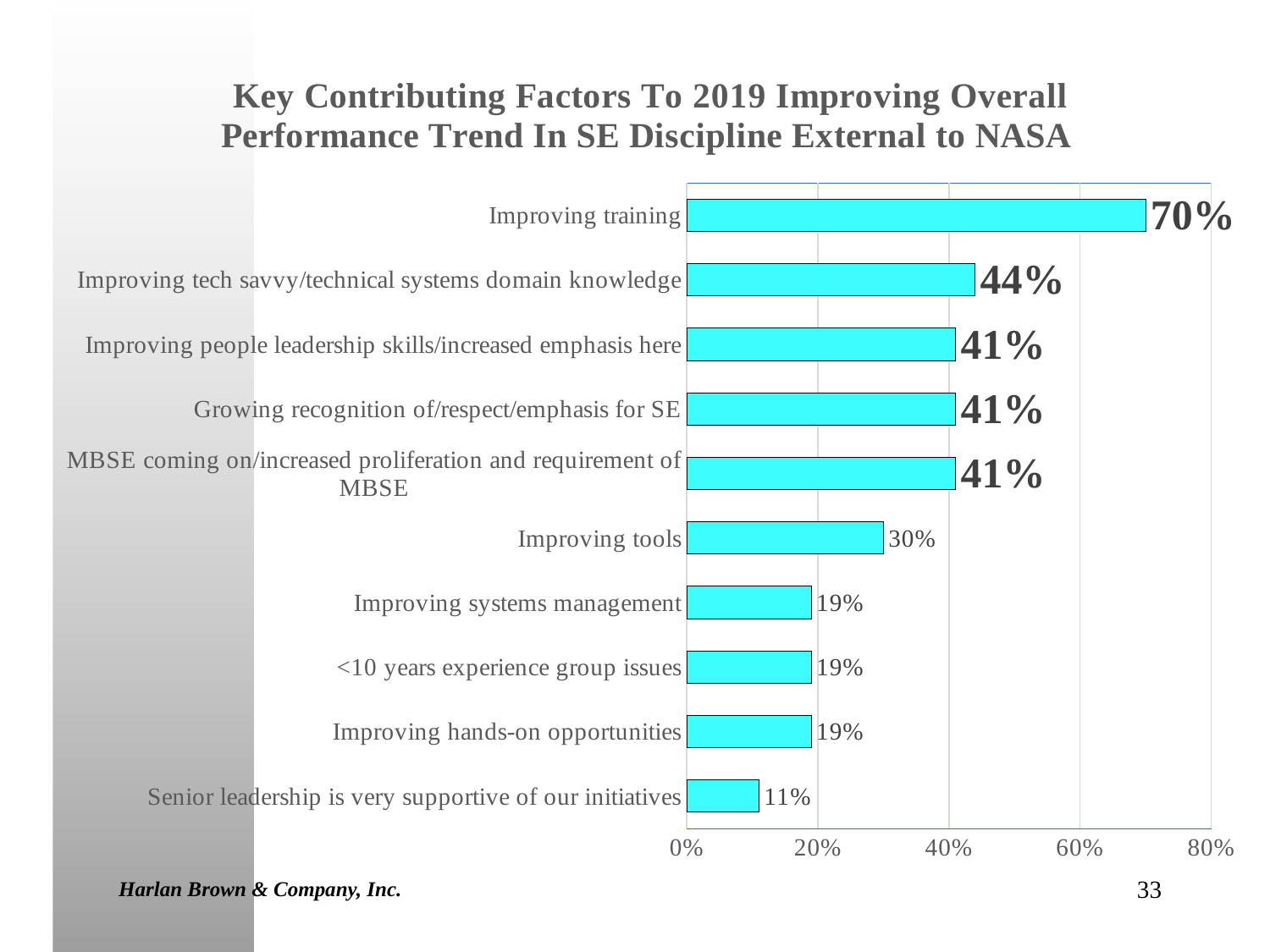
How many categories are shown in the chart? 10 Which category has the highest value? Improving training What is the difference between the values for Improving training and Improving tools? 40% What kind of chart is shown on the slide? Bar chart What is the value for Senior leadership is very supportive of our initiatives? 11% What is the value for Improving training? 70% What is the value for Improving tech savvy/technical systems domain knowledge? 44% What is the difference between the values for Improving tech savvy/technical systems domain knowledge and Growing recognition of/respect/emphasis for SE? 3% Is the value for Improving training greater or less than 60%? greater What is the value for Improving tools? 30% Which is larger, the value for Improving tools or the value for Improving systems management? Improving tools Which category has the lowest value? Senior leadership is very supportive of our initiatives